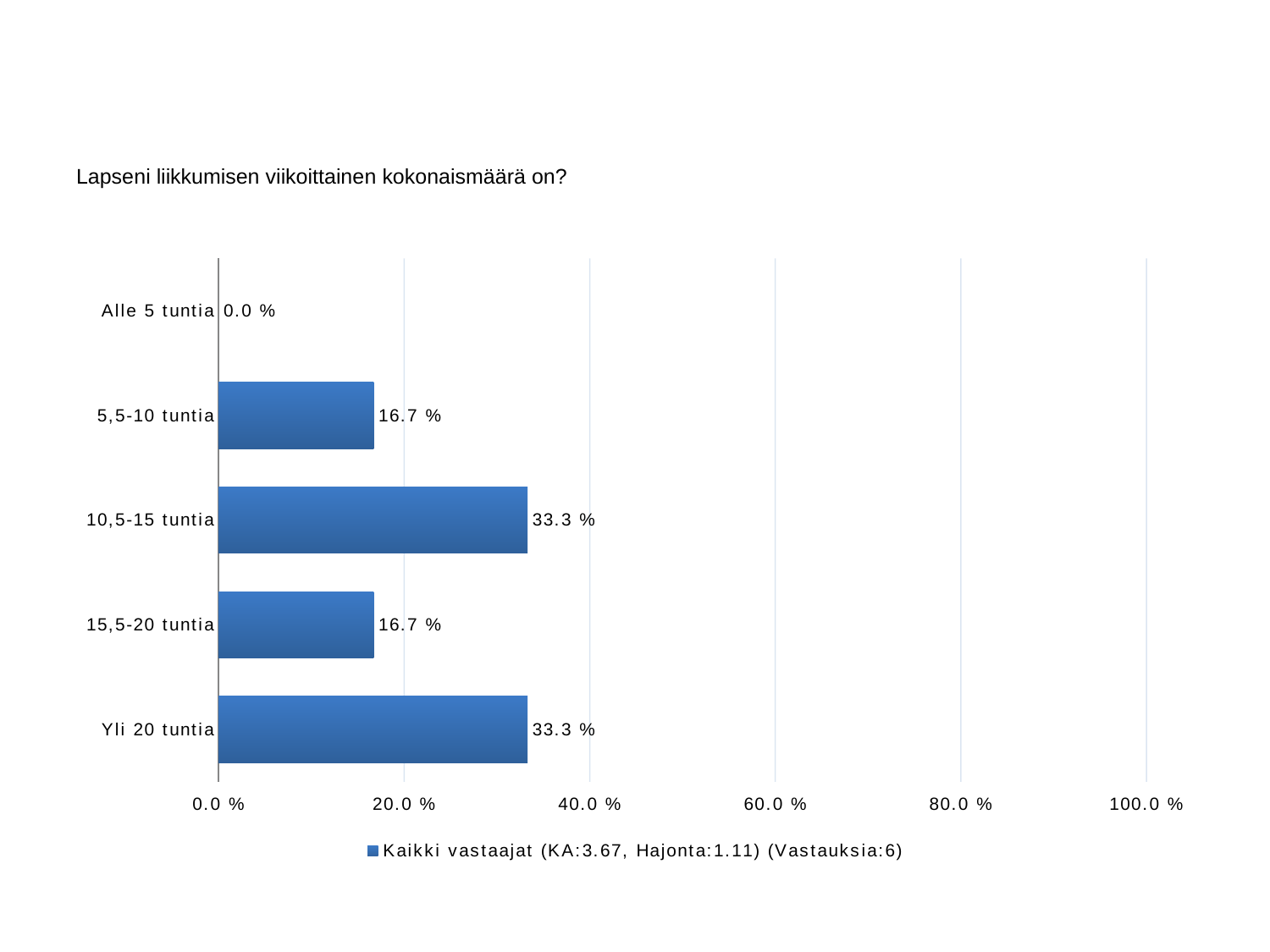
What is the value for "Yli 20 tuntia"? 33.3 % What is the title of the chart? Lapseni liikkumisen viikoittainen kokonaismäärä on? What is the value for "Alle 5 tuntia"? 0.0 % Is the value for "10,5-15 tuntia" greater or less than 40.0 %? less Which category has the lowest value? Alle 5 tuntia What is the value for "10,5-15 tuntia"? 33.3 % Which is larger, the value for "Yli 20 tuntia" or the value for "5,5-10 tuntia"? Yli 20 tuntia What kind of chart is shown on the slide? bar chart What is the difference between the values for "10,5-15 tuntia" and "15,5-20 tuntia"? 16.6 % What is the value for "5,5-10 tuntia"? 16.7 % How many categories are shown on the chart? 5 How many series does the legend list? 1